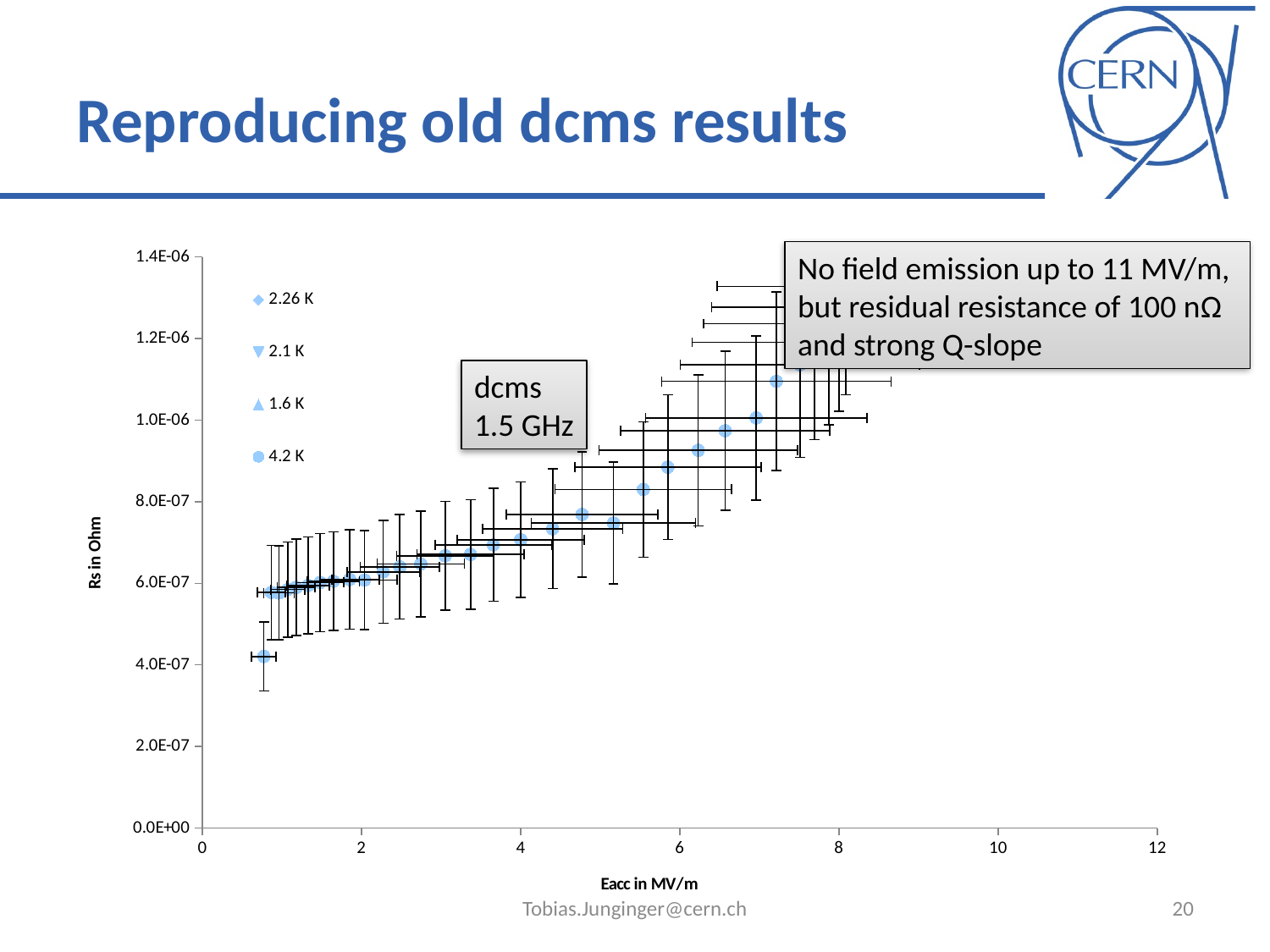
Is the highest Rs value plotted on the chart greater or less than 1.0E-06? greater Is the Rs value of the point plotted near Eacc = 4.8 MV/m greater or less than 8.0E-07? less What is the title of the x axis of the chart? Eacc in MV/m Is the Rs value of the point plotted near Eacc = 6.6 MV/m greater or less than 8.0E-07? greater What is the title of the y axis of the chart? Rs in Ohm Do the plotted Rs values rise or fall as Eacc increases along the x axis? rise How many series does the chart legend list? 4 What kind of chart is shown on the slide? scatter chart